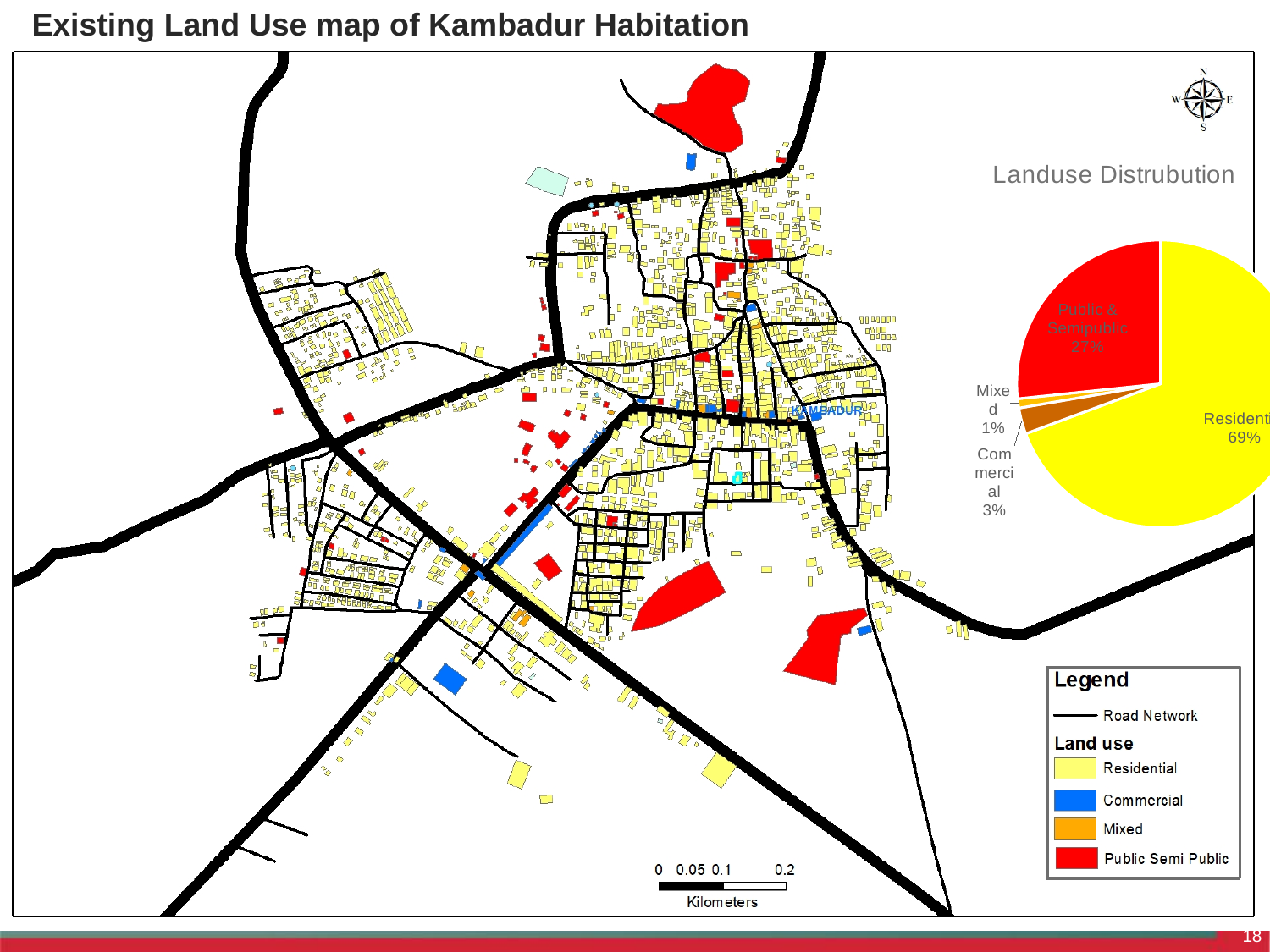
In the Landuse Distrubution pie chart, how many slices are there? 4 In the Landuse Distrubution pie chart, what share is Public & Semipublic? 27% In the Landuse Distrubution pie chart, what colour is the Public & Semipublic slice? red In the Landuse Distrubution pie chart, what share is Mixed? 1% In the Landuse Distrubution pie chart, what share is Residential? 69% In the Landuse Distrubution pie chart, what share is Commercial? 3% What is the title of the pie chart on the slide? Landuse Distrubution What kind of chart is the Landuse Distrubution chart? pie chart In the Landuse Distrubution pie chart, which is larger, Commercial or Mixed? Commercial In the Landuse Distrubution pie chart, which land use has the smallest share? Mixed In the Landuse Distrubution pie chart, what is the difference in percentage points between Residential and Public & Semipublic? 42 In the Landuse Distrubution pie chart, which land use has the largest share? Residential